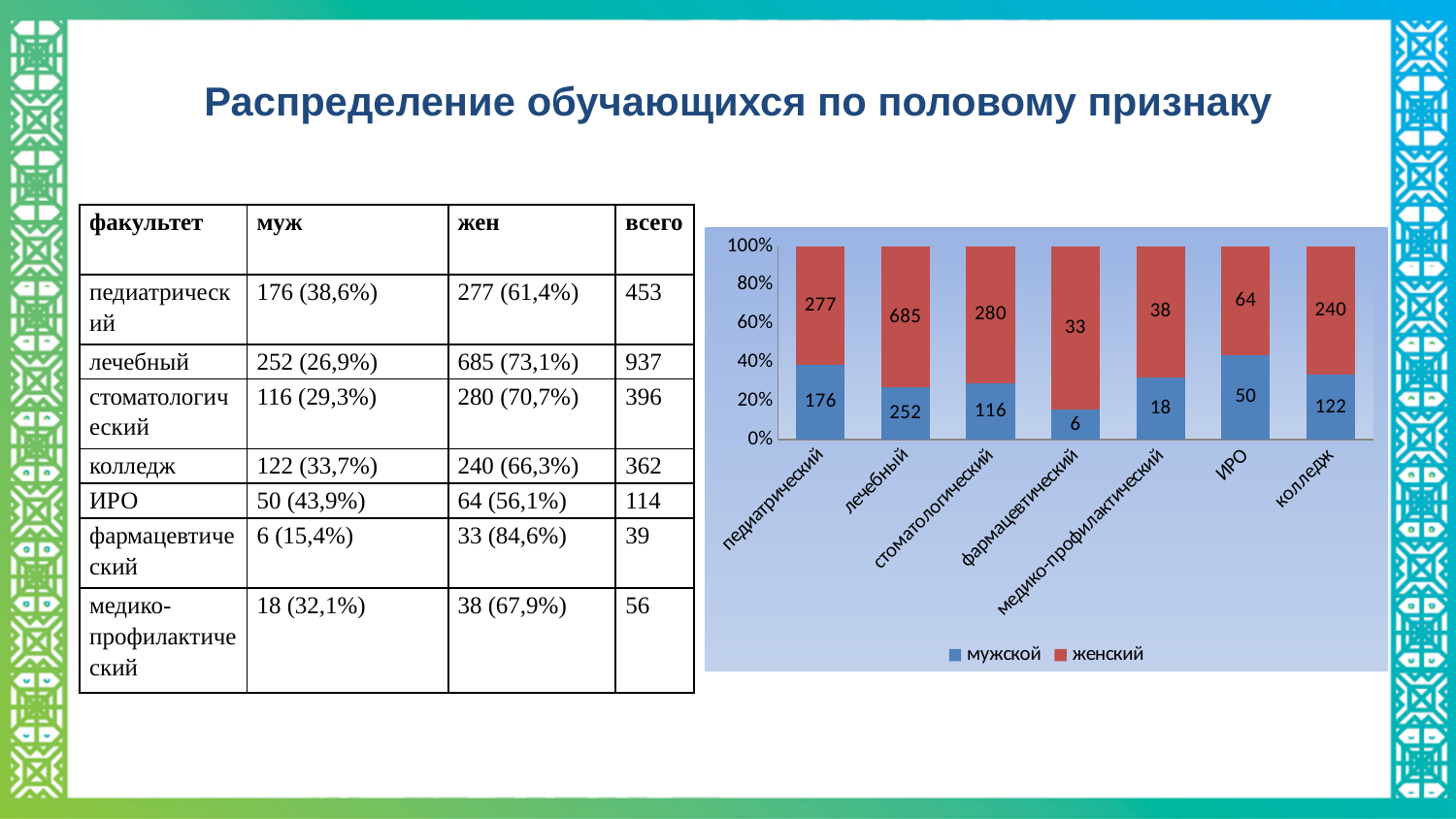
Which category has the lowest value in the мужской series? фармацевтический Which category has the highest value in the женский series? лечебный What is the value of the мужской series for фармацевтический? 6 What is the value of the мужской series for лечебный? 252 What is the value of the женский series for колледж? 240 How many series does the chart legend list? 2 Which series is shown in red in the chart? женский What is the difference between the женский and мужской values for педиатрический? 101 What is the total of the stacked bar for стоматологический? 396 Which is larger for ИРО: the мужской value or the женский value? женский What kind of chart is shown on the slide? stacked bar chart How many categories (faculties) are shown on the x axis of the chart? 7